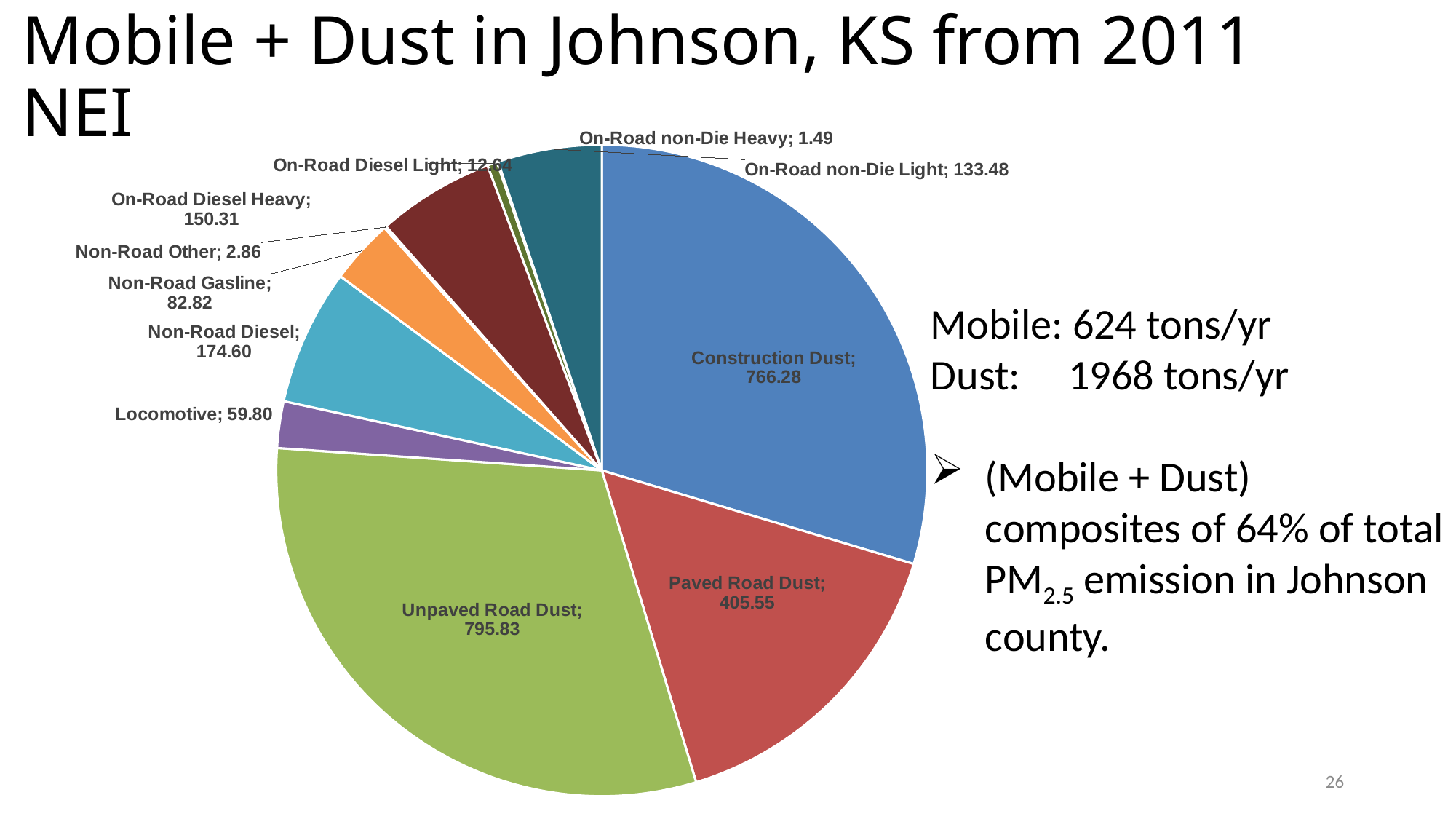
What is the difference between the values for Unpaved Road Dust and Construction Dust? 29.55 Which category has the largest slice in the pie chart? Unpaved Road Dust What is the difference between the values for Construction Dust and Paved Road Dust? 360.73 Which category has the smallest slice in the pie chart? On-Road non-Die Heavy What is the value for On-Road Diesel Heavy in the pie chart? 150.31 What type of chart is shown on the slide? Pie chart What is the value for Non-Road Diesel in the pie chart? 174.60 What is the value for Locomotive in the pie chart? 59.80 Which is larger, Non-Road Diesel or On-Road non-Die Light? Non-Road Diesel What is the value for Construction Dust in the pie chart? 766.28 How many categories (slices) does the pie chart have? 11 What is the value for Paved Road Dust in the pie chart? 405.55